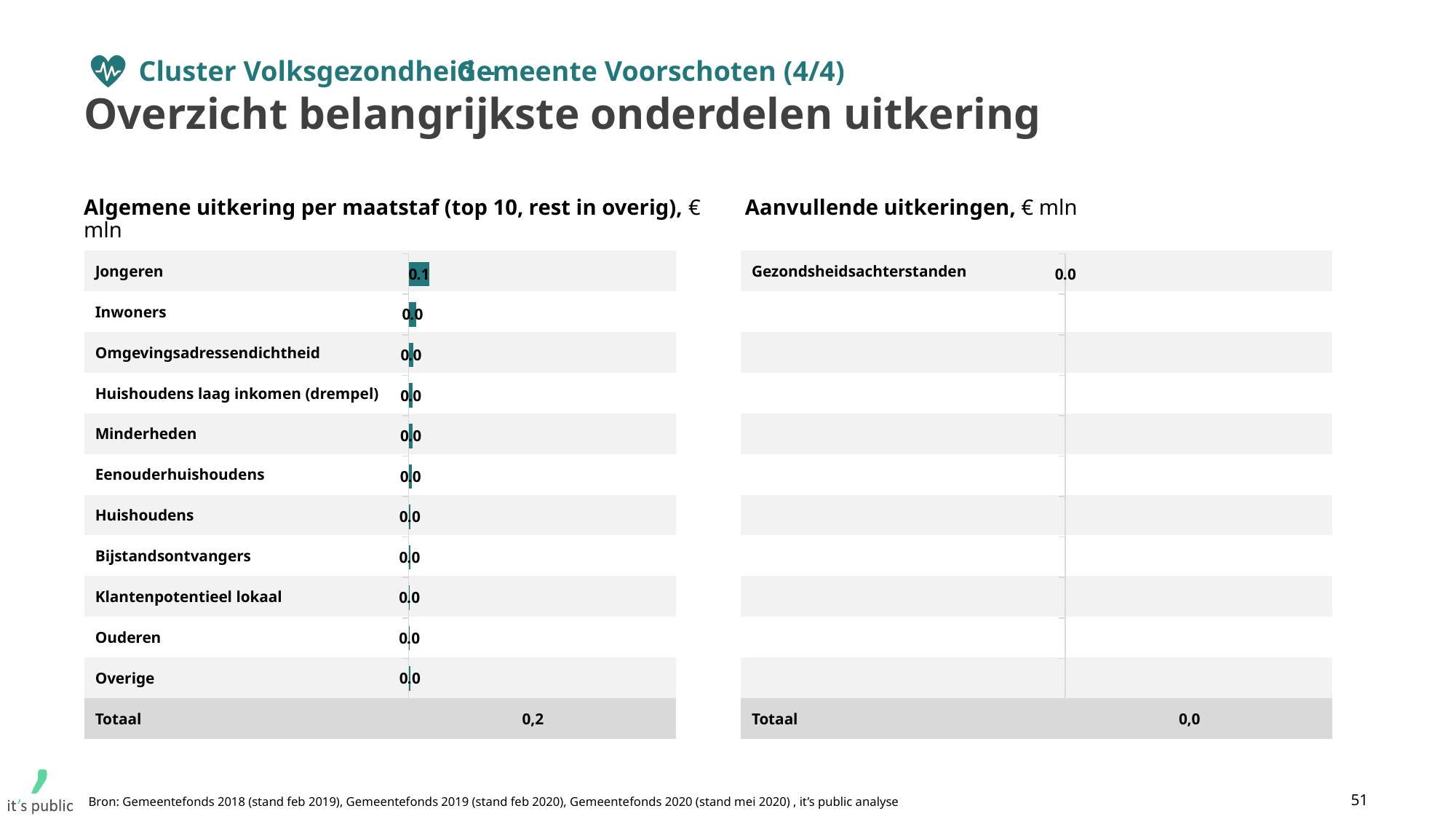
In the chart 'Algemene uitkering per maatstaf (top 10, rest in overig)', what is the Totaal value shown? 0,2 In the chart 'Algemene uitkering per maatstaf (top 10, rest in overig)', which category has the highest value? Jongeren In the chart 'Aanvullende uitkeringen', what is the Totaal value shown? 0,0 In the chart 'Algemene uitkering per maatstaf (top 10, rest in overig)', what is the value for Inwoners? 0.0 In the chart 'Algemene uitkering per maatstaf (top 10, rest in overig)', what is the difference between the values for Jongeren and Ouderen? 0.1 In what unit are the values on both charts expressed, according to the chart titles? € mln In the chart 'Algemene uitkering per maatstaf (top 10, rest in overig)', how many categories are plotted (excluding the Totaal row)? 11 What kind of chart is 'Algemene uitkering per maatstaf (top 10, rest in overig)'? Bar chart In the chart 'Aanvullende uitkeringen', what is the value for Gezondsheidsachterstanden? 0.0 In the chart 'Algemene uitkering per maatstaf (top 10, rest in overig)', what is the value for Jongeren? 0.1 In the chart 'Algemene uitkering per maatstaf (top 10, rest in overig)', which is larger: the value for Jongeren or the value for Minderheden? Jongeren In the chart 'Aanvullende uitkeringen', how many categories are plotted (excluding the Totaal row)? 1